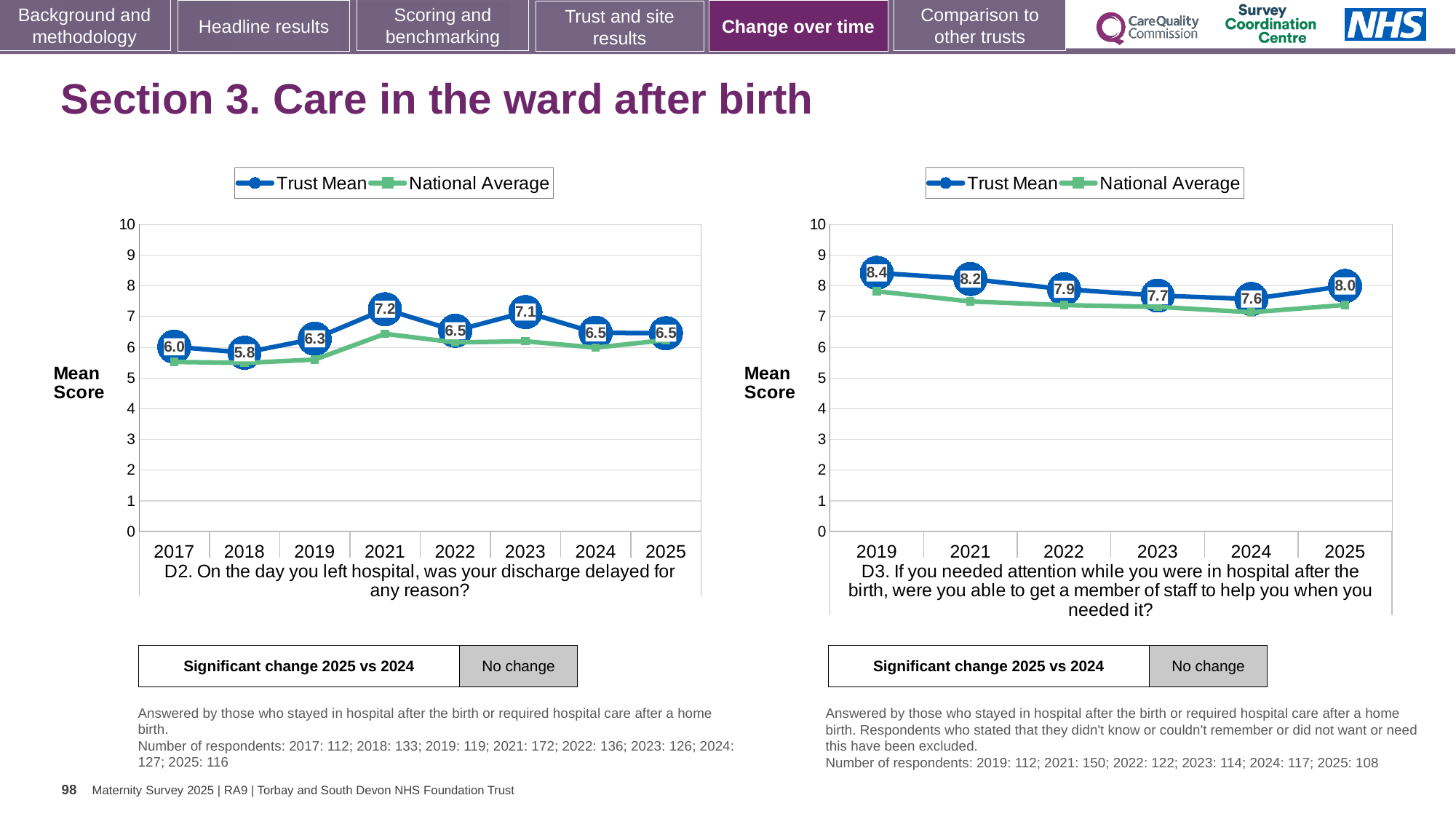
In the left chart (D2), what is the difference between the Trust Mean in 2021 and in 2018? 1.4 What type of chart is used for the D3 question on the right? Line chart In the right chart (D3), what is the difference between the Trust Mean in 2019 and in 2024? 0.8 In the left chart (D2), which year has the lowest Trust Mean? 2018 How many years are plotted on the x axis of the left chart (D2)? 8 In the right chart (D3), does the Trust Mean rise or fall from 2019 to 2024? Fall In the left chart (D2, discharge delayed), what is the Trust Mean for 2021? 7.2 In the right chart (D3), is the National Average for 2019 greater or less than 7? greater In the right chart (D3, able to get a member of staff to help), what is the Trust Mean for 2019? 8.4 How many series does the legend of the right chart (D3) list? 2 In the right chart (D3), which year has the highest Trust Mean? 2019 In the left chart (D2), is the Trust Mean higher in 2023 or in 2024? 2023